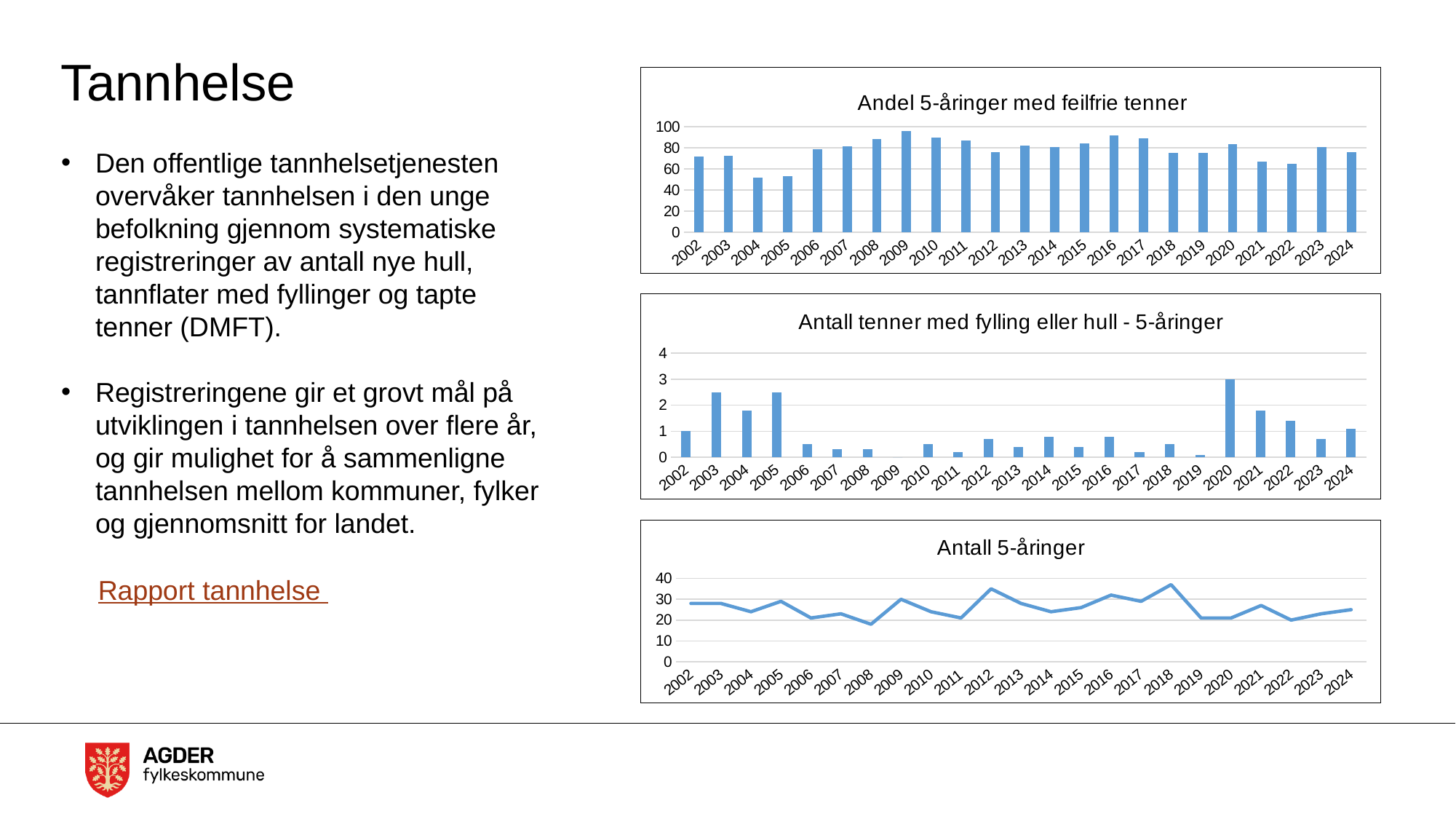
In the top chart 'Andel 5-åringer med feilfrie tenner', is the value for 2016 greater or less than 80? greater In the top chart 'Andel 5-åringer med feilfrie tenner', is the value for 2004 greater or less than 60? less In the top chart 'Andel 5-åringer med feilfrie tenner', which is larger, the value for 2009 or the value for 2004? 2009 In the bottom chart 'Antall 5-åringer', is the value for 2008 greater or less than 20? less How many years are shown on the x axis of the top chart 'Andel 5-åringer med feilfrie tenner'? 23 In the bottom chart 'Antall 5-åringer', which year has the highest value? 2018 What kind of chart is the top chart, 'Andel 5-åringer med feilfrie tenner'? bar chart In the middle chart 'Antall tenner med fylling eller hull - 5-åringer', which is larger, the value for 2003 or the value for 2004? 2003 In the middle chart 'Antall tenner med fylling eller hull - 5-åringer', which year has the highest value? 2020 In the top chart 'Andel 5-åringer med feilfrie tenner', which year has the highest value? 2009 What kind of chart is the bottom chart, 'Antall 5-åringer'? line chart